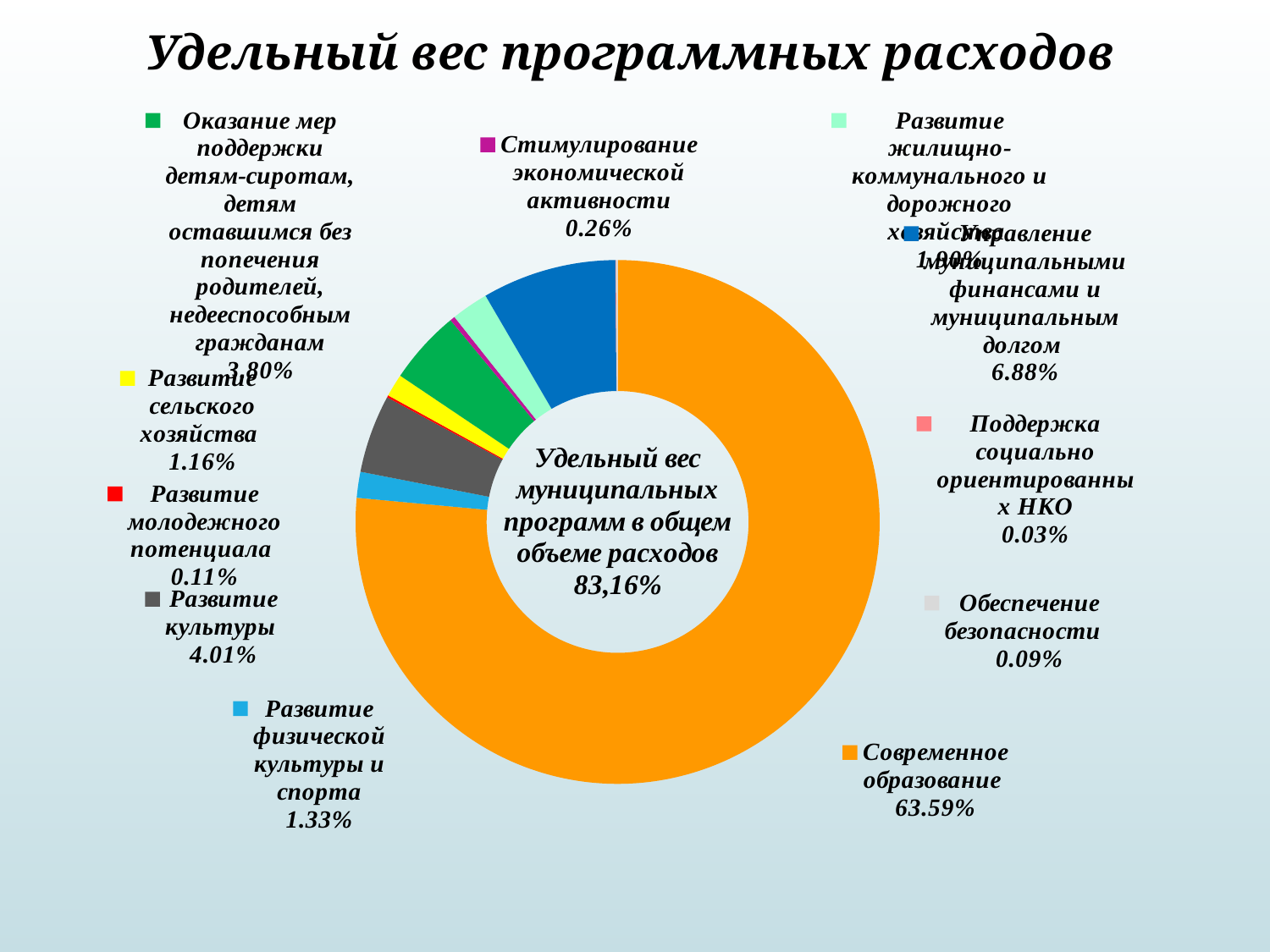
What share of the chart does Современное образование account for? 63.59% How many categories are shown in the chart? 11 Which category has the largest share of the chart? Современное образование What kind of chart is shown on the slide? Doughnut (pie) chart What is the value shown for Развитие физической культуры и спорта? 1.33% Which is larger: Развитие культуры or Развитие сельского хозяйства? Развитие культуры What is the value shown for Управление муниципальными финансами и муниципальным долгом? 6.88% Which category has the smallest share of the chart? Поддержка социально ориентированных НКО What is the value shown for Обеспечение безопасности? 0.09% What percentage is printed in the centre of the doughnut chart? 83,16% What is the difference between the shares of Современное образование and Управление муниципальными финансами и муниципальным долгом? 56.71% What is the value shown for Развитие культуры? 4.01%